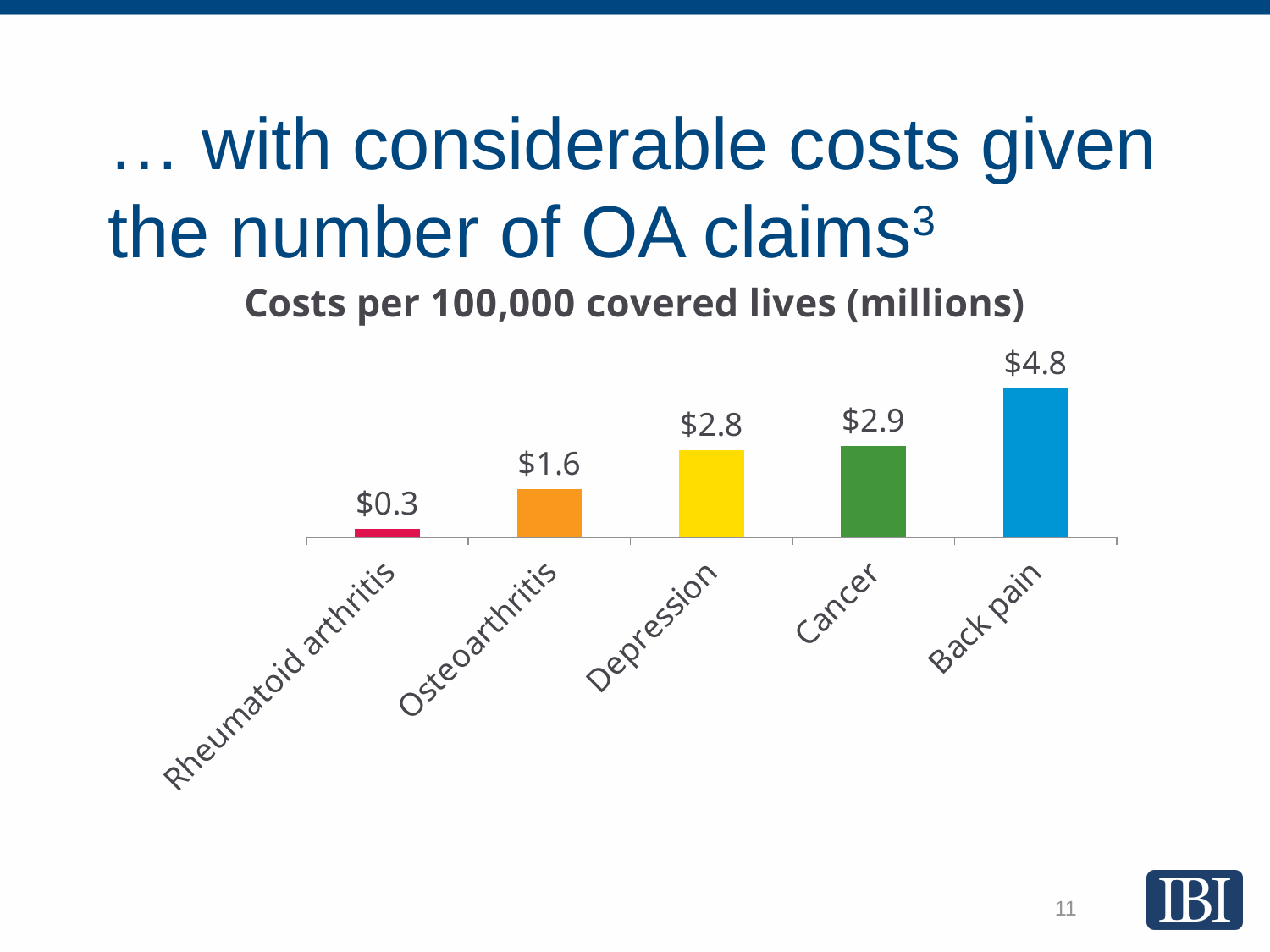
What is the difference in cost between Back pain and Osteoarthritis? $3.2 What is the cost per 100,000 covered lives for Osteoarthritis? $1.6 What is the cost per 100,000 covered lives for Back pain? $4.8 What is the title of the chart? Costs per 100,000 covered lives (millions) How many categories are shown in the chart? 5 Which category has the lowest cost per 100,000 covered lives? Rheumatoid arthritis What is the cost per 100,000 covered lives for Rheumatoid arthritis? $0.3 What kind of chart is shown on the slide? Bar chart Which has a higher cost per 100,000 covered lives, Osteoarthritis or Depression? Depression What is the difference in cost between Cancer and Depression? $0.1 Which category has the highest cost per 100,000 covered lives? Back pain What is the cost per 100,000 covered lives for Depression? $2.8